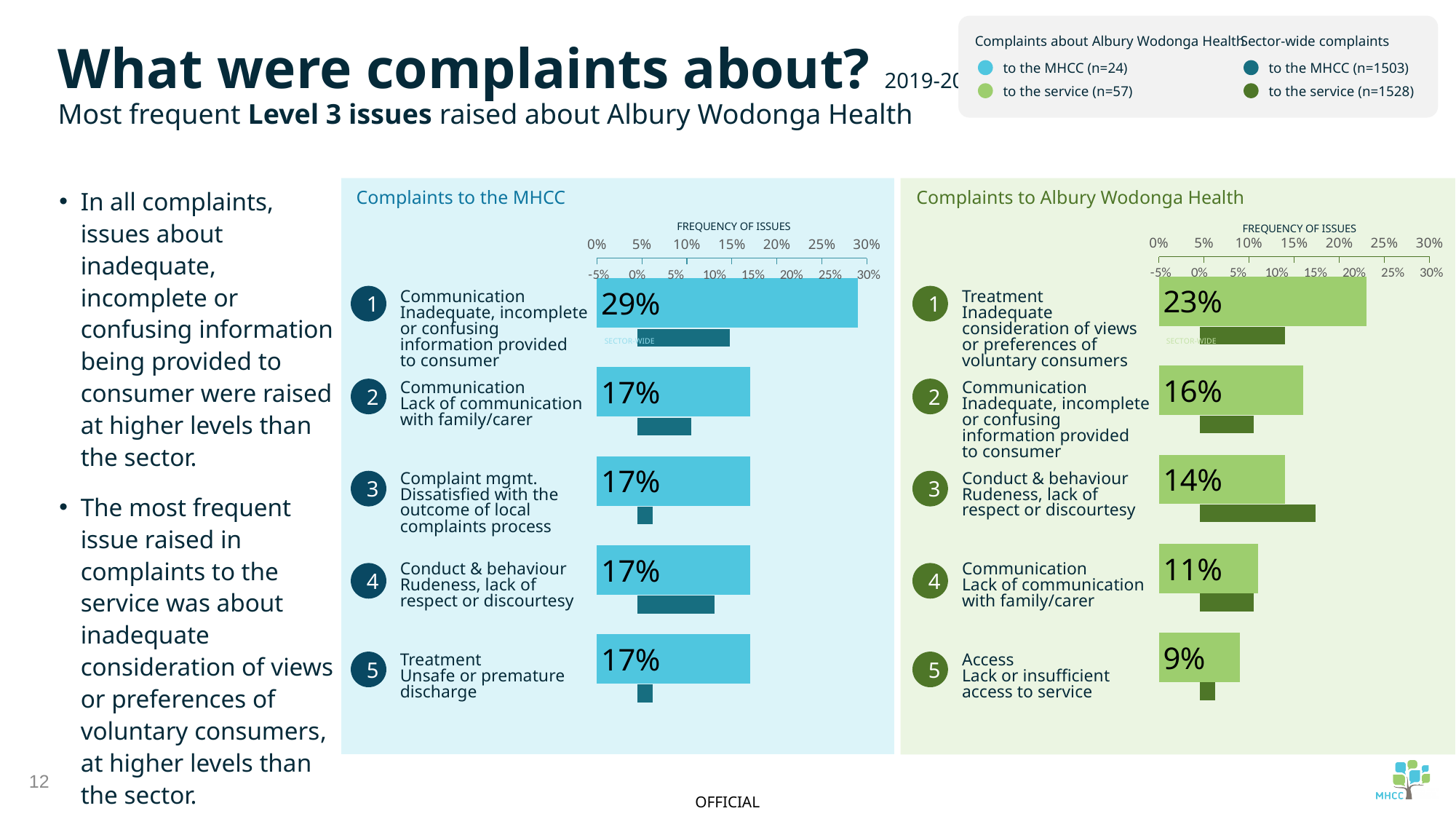
In the 'Complaints to the MHCC' chart, is the sector-wide value for issue 1 (Communication – inadequate information) greater or less than 20%? less In the 'Complaints to Albury Wodonga Health' chart, what is the difference between the frequency for Treatment (23%) and Communication – inadequate information (16%)? 7 percentage points How many issues are listed in the 'Complaints to Albury Wodonga Health' chart? 5 In the 'Complaints to Albury Wodonga Health' chart, which issue has the lowest frequency? Access – Lack or insufficient access to service In the 'Complaints to the MHCC' chart, what is the frequency for issue 1, Communication – inadequate, incomplete or confusing information provided to consumer? 29% In the 'Complaints to Albury Wodonga Health' chart, what is the frequency for issue 5, Access – lack or insufficient access to service? 9% In the 'Complaints to the MHCC' chart, what is the difference between the frequency for issue 1 (29%) and issue 2 (17%)? 12 percentage points Which is larger: the frequency for Communication – lack of communication with family/carer in the 'Complaints to the MHCC' chart or in the 'Complaints to Albury Wodonga Health' chart? Complaints to the MHCC (17%) In the 'Complaints to Albury Wodonga Health' chart, is the sector-wide value for Conduct & behaviour greater or less than 10%? greater In the 'Complaints to the MHCC' chart, which issue has the highest frequency? Communication – Inadequate, incomplete or confusing information provided to consumer In the 'Complaints to Albury Wodonga Health' chart, what is the frequency for Conduct & behaviour – rudeness, lack of respect or discourtesy? 14% What type of chart is used for 'Complaints to the MHCC'? Bar chart